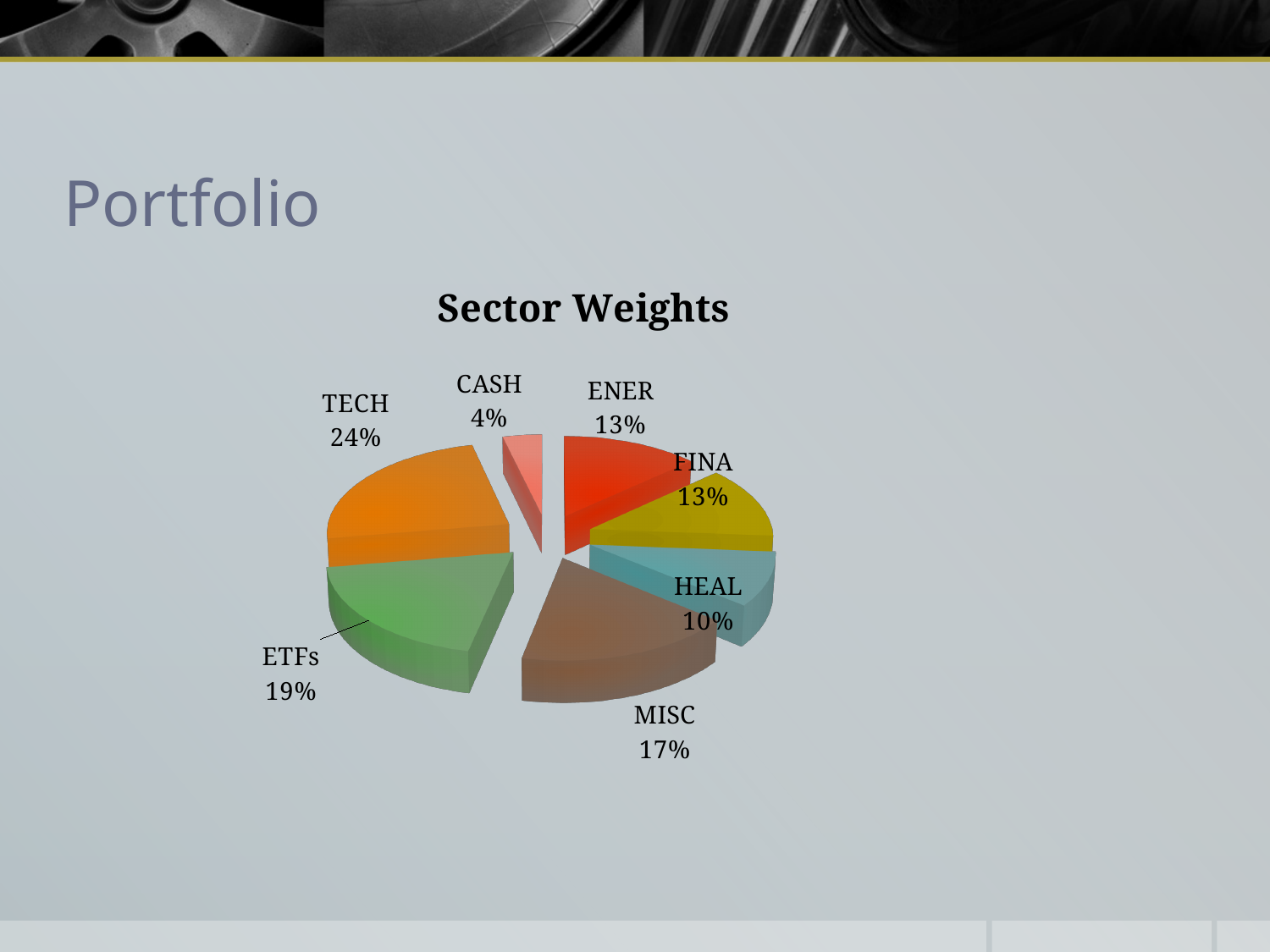
Which sector has the largest weight? TECH What is the difference between the TECH and ETFs weights? 5% What is the combined weight of ENER and FINA? 26% What is the sector weight for CASH? 4% What is the sector weight for MISC? 17% What kind of chart is shown on the slide? pie chart What is the sector weight for HEAL? 10% Which sector has the smallest weight? CASH How many sectors are shown in the pie chart? 7 What is the title of the chart? Sector Weights What is the sector weight for TECH? 24% Which has a larger weight, MISC or HEAL? MISC